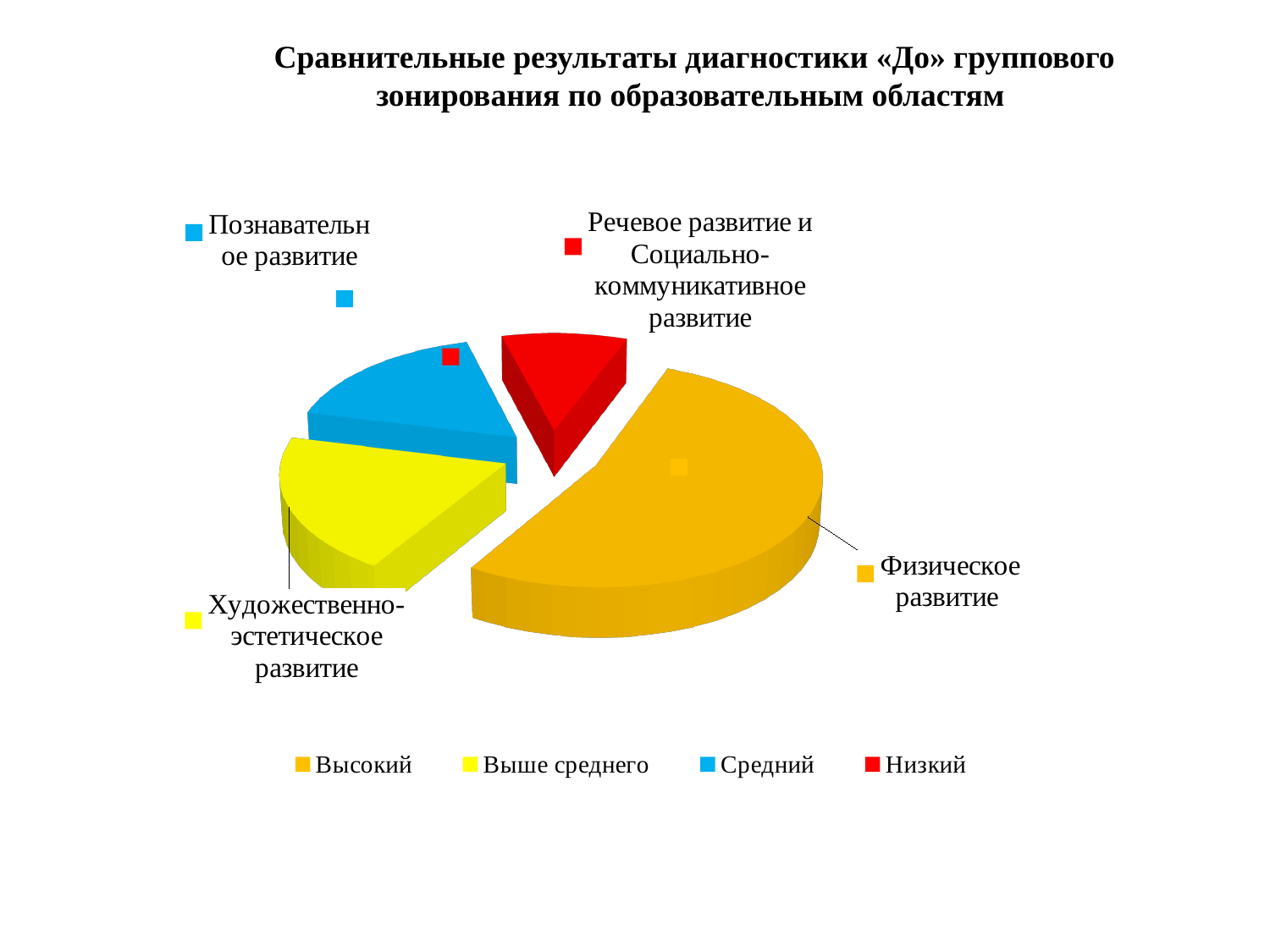
Which slice of the pie chart is the largest? Физическое развитие What kind of chart is shown on the slide? pie chart Which slice is larger: Познавательное развитие or Речевое развитие и Социально-коммуникативное развитие? Познавательное развитие Which legend entry is shown in red? Низкий What is the title of the chart on the slide? Сравнительные результаты диагностики «До» группового зонирования по образовательным областям Which slice is larger: Физическое развитие or Художественно-эстетическое развитие? Физическое развитие Which slice of the pie chart is the smallest? Речевое развитие и Социально-коммуникативное развитие How many slices does the pie chart have? 4 How many entries does the legend list? 4 Which slice is larger: Художественно-эстетическое развитие or Речевое развитие и Социально-коммуникативное развитие? Художественно-эстетическое развитие